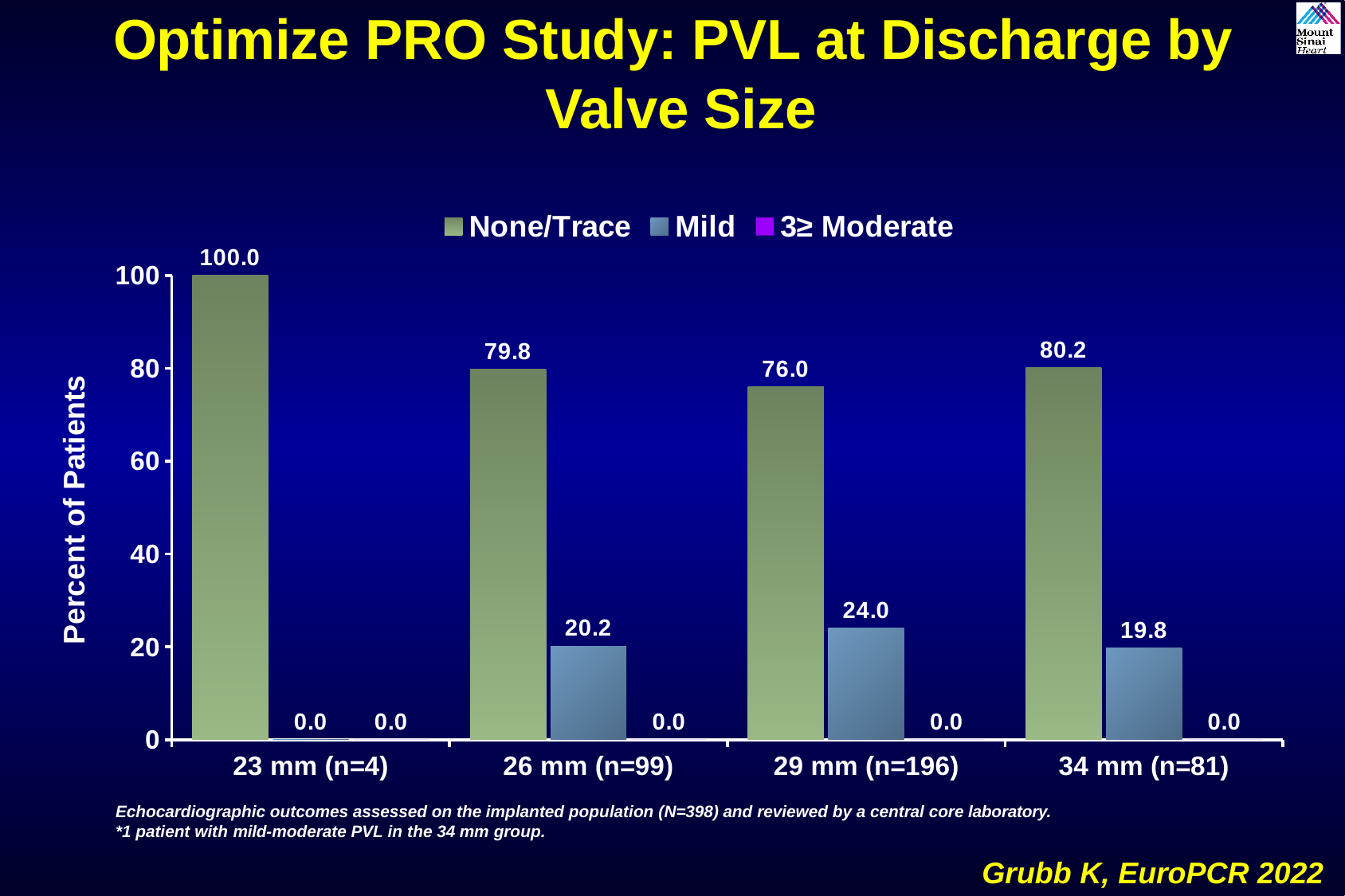
What is the label of the y axis? Percent of Patients What is the difference between the None/Trace values for the 34 mm (n=81) and 26 mm (n=99) groups? 0.4 How many valve size groups are shown on the x axis? 4 What is the None/Trace value for the 29 mm (n=196) group? 76.0 What kind of chart is shown on the slide? Bar chart Which valve size group has the highest None/Trace value? 23 mm (n=4) Which valve size group has the highest Mild value? 29 mm (n=196) How many series does the legend list? 3 Which is larger, the Mild value for 26 mm (n=99) or for 34 mm (n=81)? 26 mm (n=99) What is the Mild value for the 26 mm (n=99) group? 20.2 What is the Mild value for the 34 mm (n=81) group? 19.8 Which valve size group has the lowest None/Trace value? 29 mm (n=196)